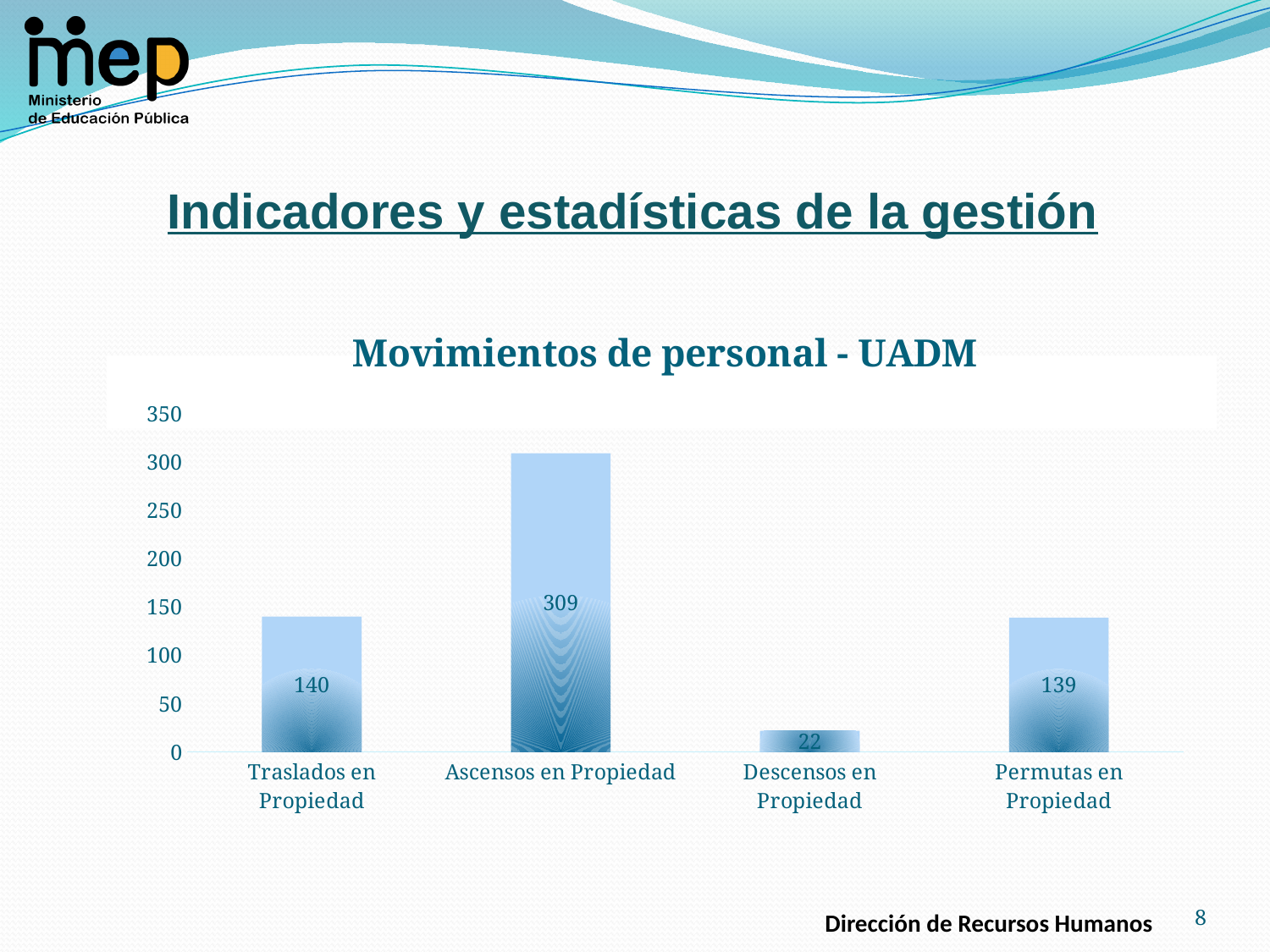
What is the value for Descensos en Propiedad? 22 Which is larger, the value for Ascensos en Propiedad or the value for Permutas en Propiedad? Ascensos en Propiedad Which category has the highest value? Ascensos en Propiedad What is the difference between the values for Ascensos en Propiedad and Traslados en Propiedad? 169 What is the difference between the values for Permutas en Propiedad and Descensos en Propiedad? 117 How many categories are shown on the x axis? 4 What is the value for Traslados en Propiedad? 140 Which category has the lowest value? Descensos en Propiedad What is the title of the chart? Movimientos de personal - UADM What kind of chart is shown on the slide? Bar chart What is the value for Permutas en Propiedad? 139 What is the value for Ascensos en Propiedad? 309